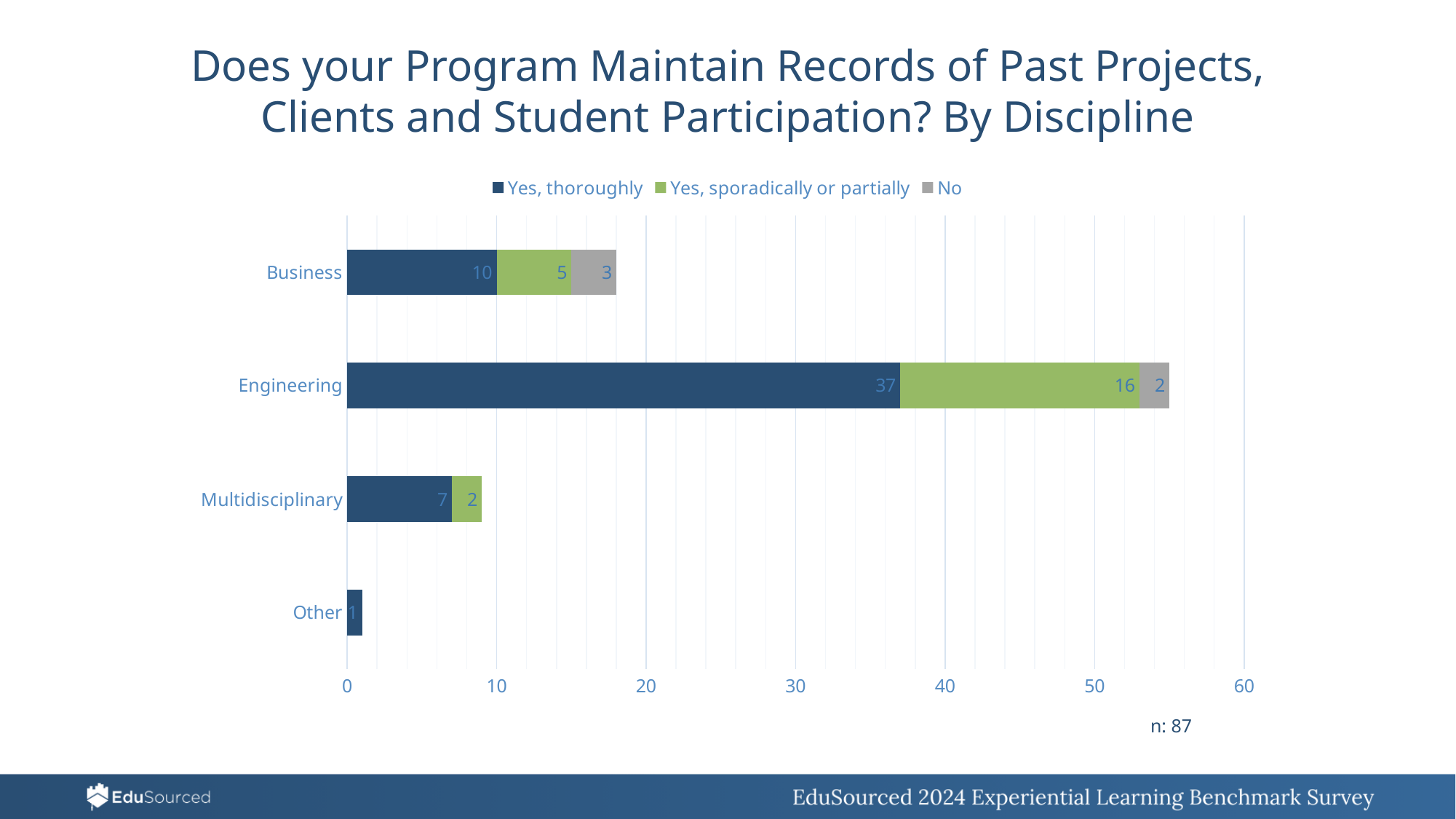
What is the 'Yes, sporadically or partially' value for Business? 5 How many series does the legend list? 3 What is the total of the stacked bar for Engineering? 55 What is the total of the stacked bar for Business? 18 What is the difference between the 'Yes, thoroughly' values for Engineering and Business? 27 Which is larger, the 'No' value for Business or the 'No' value for Engineering? Business What is the 'No' value for Engineering? 2 What is the 'Yes, thoroughly' value for Multidisciplinary? 7 Which discipline has the highest 'Yes, thoroughly' value? Engineering Which discipline has the lowest 'Yes, thoroughly' value? Other What kind of chart is shown on the slide? Stacked bar chart What is the 'Yes, thoroughly' value for Engineering? 37